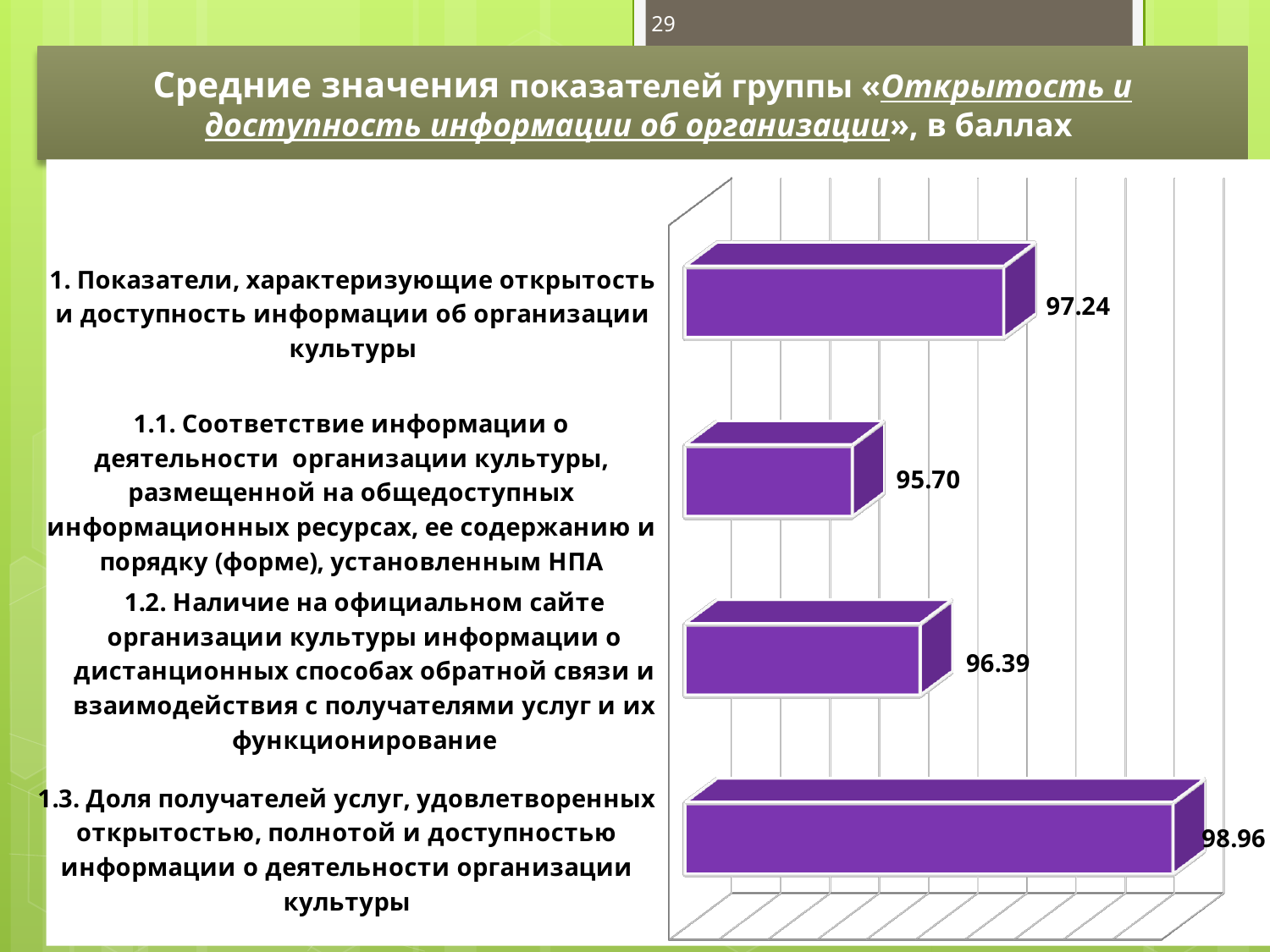
Which is larger: the value for indicator 1.2 or the value for indicator 1.1? Indicator 1.2 What is the difference between the values for indicator 1 and indicator 1.2? 0.85 What colour are the bars in the chart? Purple What is the value for indicator 1 (Показатели, характеризующие открытость и доступность информации об организации культуры)? 97.24 What is the difference between the values for indicator 1.3 and indicator 1.1? 3.26 What is the value for indicator 1.1 (Соответствие информации о деятельности организации культуры, размещенной на общедоступных информационных ресурсах)? 95.70 How many bars are shown in the chart? 4 What is the value for indicator 1.3 (Доля получателей услуг, удовлетворенных открытостью, полнотой и доступностью информации)? 98.96 What type of chart is shown on the slide? Bar chart Which indicator has the highest value? 1.3. Доля получателей услуг, удовлетворенных открытостью, полнотой и доступностью информации о деятельности организации культуры What is the value for indicator 1.2 (Наличие на официальном сайте организации культуры информации о дистанционных способах обратной связи)? 96.39 Which indicator has the lowest value? 1.1. Соответствие информации о деятельности организации культуры, размещенной на общедоступных информационных ресурсах, ее содержанию и порядку (форме), установленным НПА